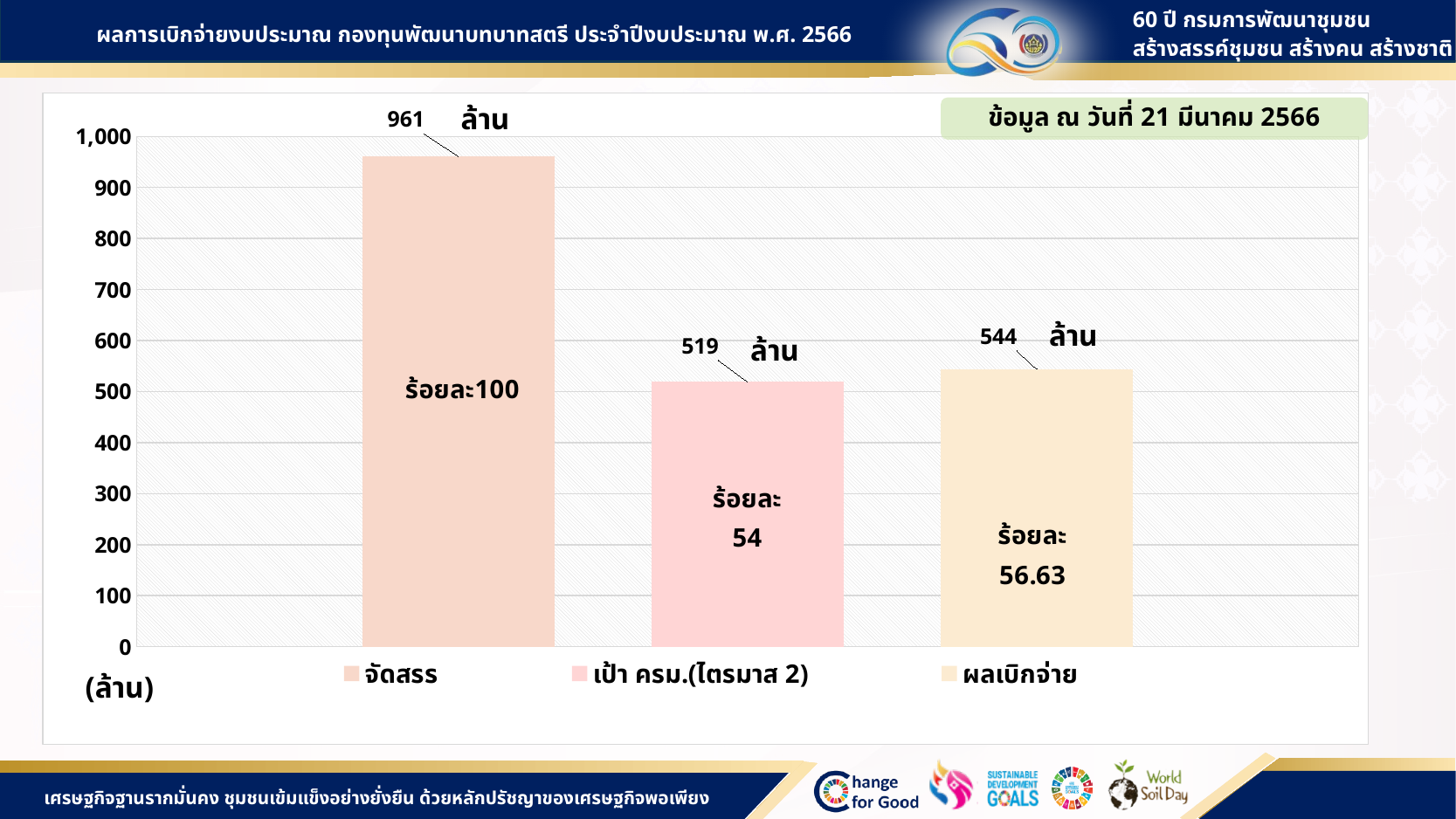
Which category has the lowest value? เป้า ครม.(ไตรมาส 2) What is the value for จัดสรร? 961 ล้าน Which category has the highest value? จัดสรร How many bars are shown in the chart? 3 What percentage is printed inside the เป้า ครม.(ไตรมาส 2) bar? ร้อยละ 54 What is the value for ผลเบิกจ่าย? 544 ล้าน How many entries does the legend list? 3 What percentage is printed inside the ผลเบิกจ่าย bar? ร้อยละ 56.63 Which is larger, the value for ผลเบิกจ่าย or the value for เป้า ครม.(ไตรมาส 2)? ผลเบิกจ่าย What kind of chart is shown on the slide? Bar chart What is the value for เป้า ครม.(ไตรมาส 2)? 519 ล้าน What is the difference between the values for จัดสรร and ผลเบิกจ่าย? 417 ล้าน